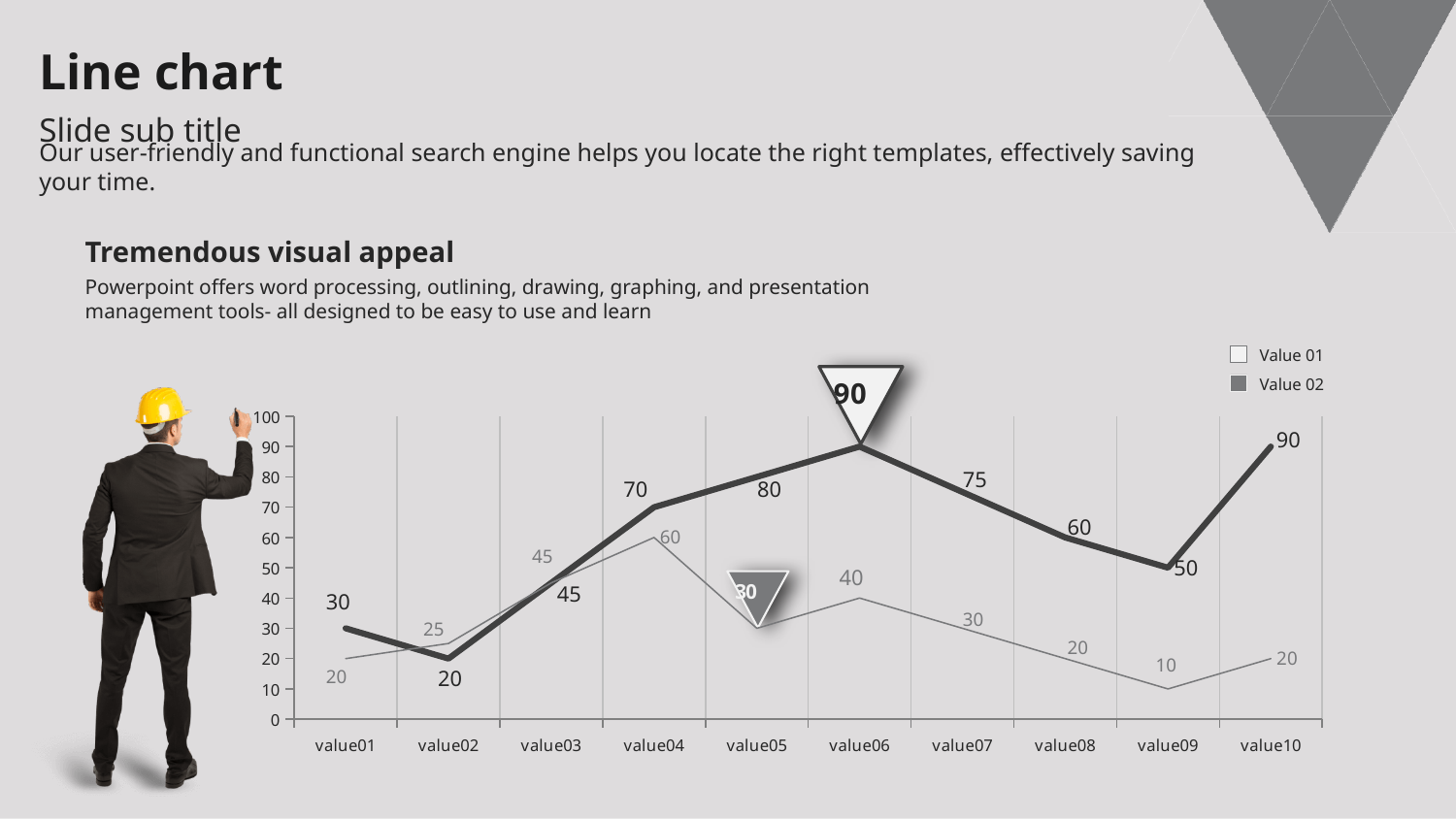
How many categories are plotted along the x axis? 10 What is the value of Value 02 at value07? 75 What is the value of Value 01 at value04? 60 At which category does Value 02 reach its lowest value? value02 How many series does the legend list? 2 Which series has the larger value at value01, Value 01 or Value 02? Value 02 What is the difference between Value 02 and Value 01 at value05? 50 At which category does Value 01 reach its lowest value? value09 What is the value of Value 02 at value06? 90 Does Value 01 rise or fall from value06 to value09? fall At which category does Value 01 reach its highest value? value04 What type of chart is shown on the slide? line chart